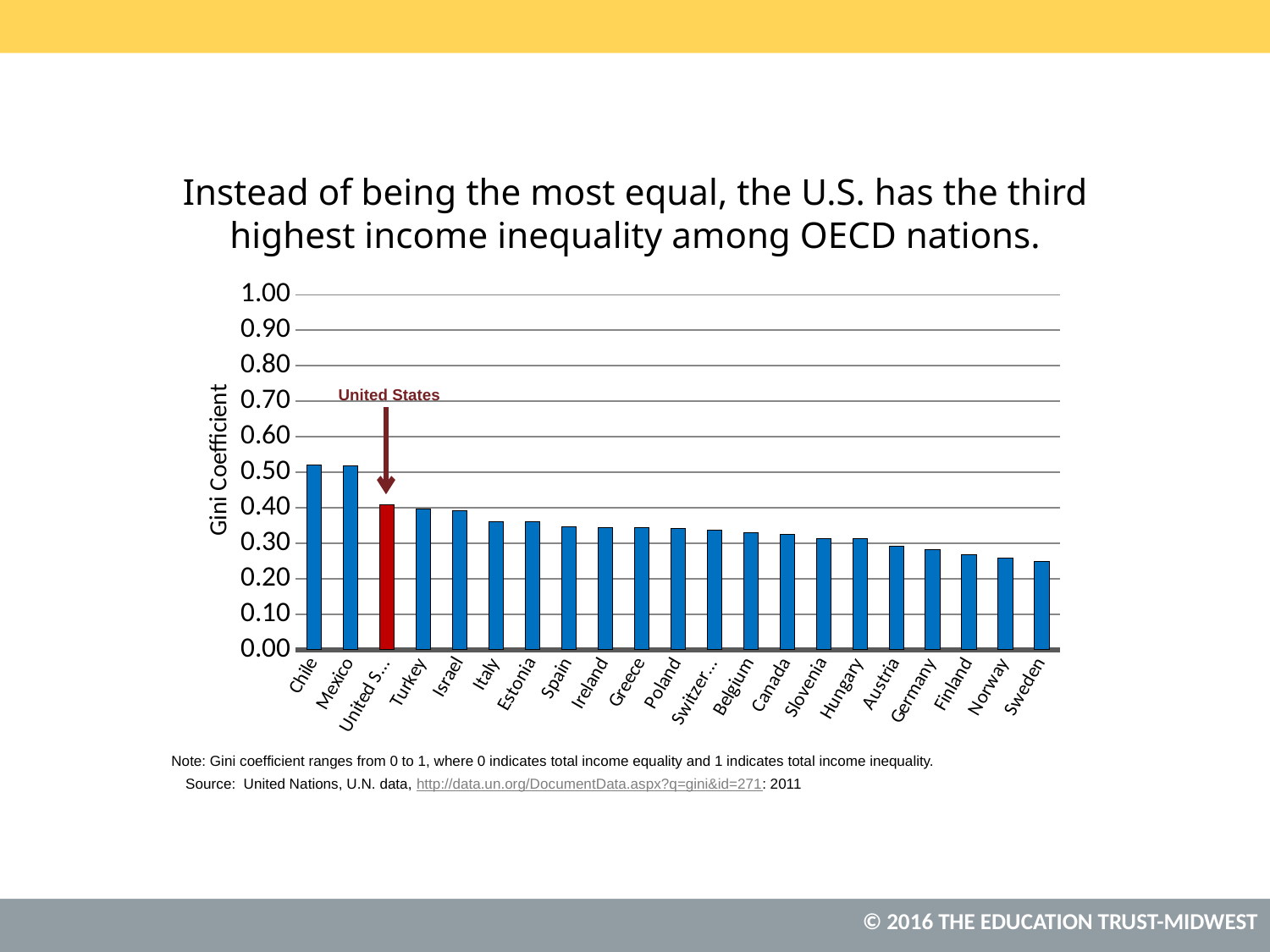
Is the value for Sweden greater or less than 0.30? less Which has the higher Gini coefficient, Chile or Sweden? Chile Do the values rise or fall moving from left to right along the x axis? fall What is the label on the vertical axis of the chart? Gini Coefficient Which country's bar is highlighted in red and marked with an arrow? United States How many countries are plotted in the chart? 21 Is the value for Italy greater or less than 0.40? less Which has the higher Gini coefficient, Israel or Germany? Israel Is the value for Chile greater or less than 0.50? greater What kind of chart is shown on the slide? bar chart